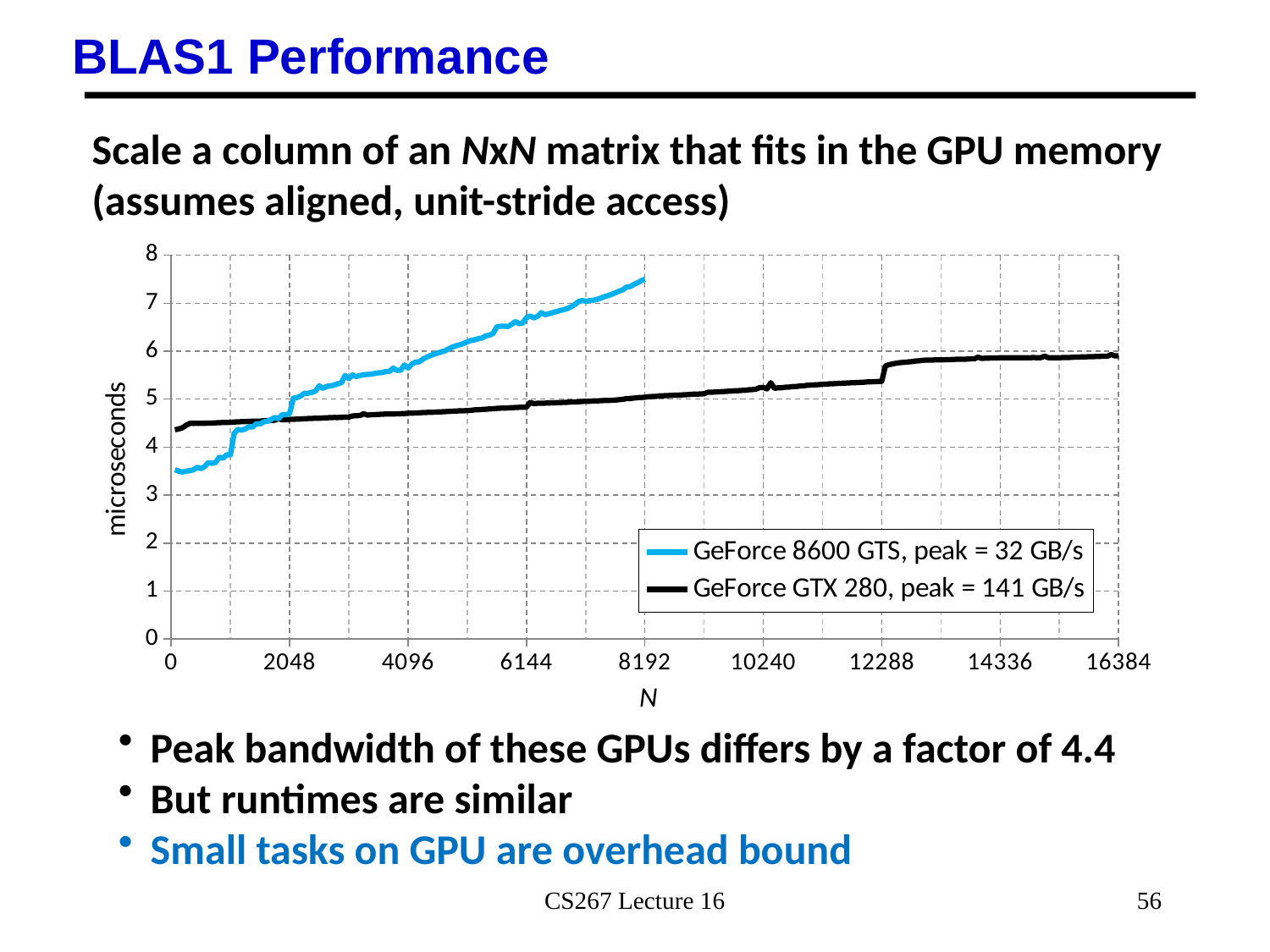
Near N = 0, which series has the larger value, GeForce 8600 GTS or GeForce GTX 280? GeForce GTX 280 Is the value for GeForce 8600 GTS at N = 8192 greater or less than 7? greater What kind of chart is shown on the slide? line chart Is the value for GeForce GTX 280 at N = 16384 greater or less than 5? greater At N = 4096, which series has the larger value, GeForce 8600 GTS or GeForce GTX 280? GeForce 8600 GTS Is the value for GeForce 8600 GTS near N = 0 greater or less than 4? less Do the values for GeForce 8600 GTS rise or fall as N increases? rise What are the two series named in the legend? GeForce 8600 GTS, peak = 32 GB/s; GeForce GTX 280, peak = 141 GB/s How many series does the legend list? 2 What is the label of the y axis? microseconds